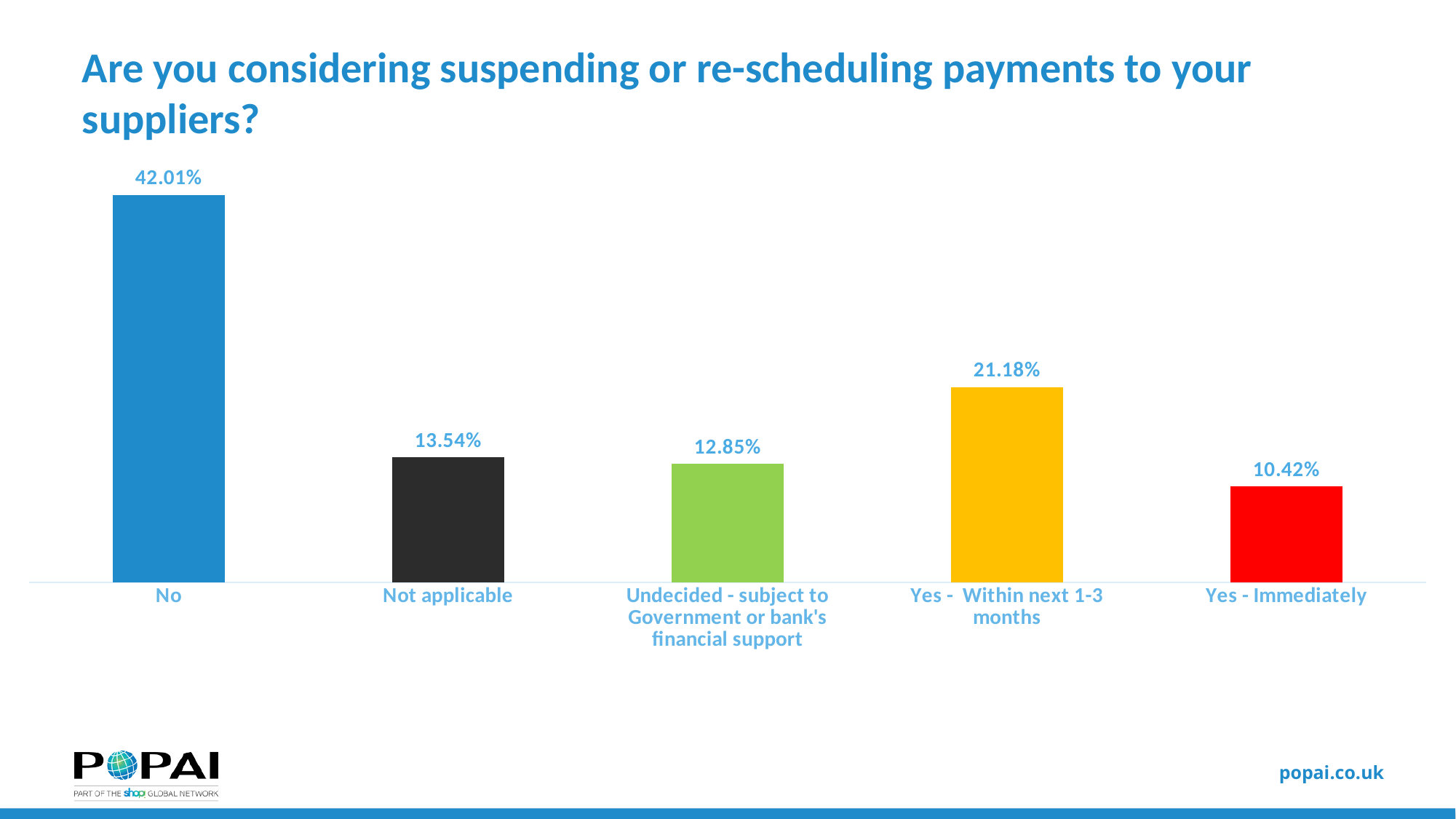
What is the value for "Yes - Immediately"? 10.42% Which is larger, the value for "Not applicable" or the value for "Undecided - subject to Government or bank's financial support"? Not applicable How many categories are shown in the chart? 5 Which category has the lowest value? Yes - Immediately What is the difference between the values for "No" and "Yes - Within next 1-3 months"? 20.83% What kind of chart is shown on the slide? Bar chart What is the value for "Undecided - subject to Government or bank's financial support"? 12.85% What colour is the bar for "Yes - Within next 1-3 months"? Yellow What percentage of respondents answered "No"? 42.01% Which category has the highest value? No What is the value for "Yes - Within next 1-3 months"? 21.18% What is the difference between the values for "Not applicable" and "Yes - Immediately"? 3.12%